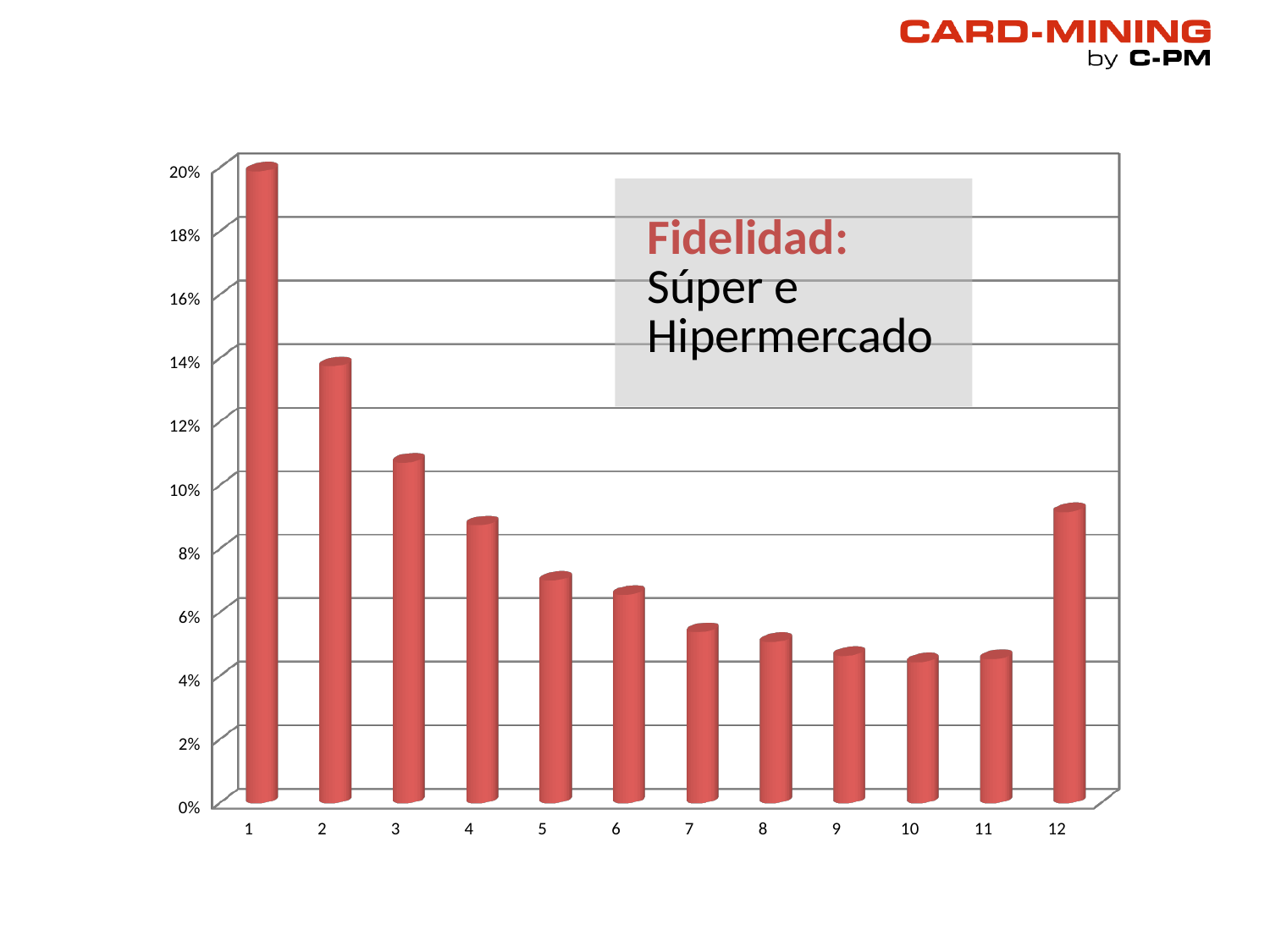
Is the value for category 4 greater or less than 8%? greater What text appears in the box overlaid on the chart? Fidelidad: Súper e Hipermercado Is the value for category 12 greater or less than 10%? less What kind of chart is shown on the slide? bar chart Which is larger, the value for category 2 or category 3? 2 How many categories are plotted along the x axis? 12 Is the value for category 2 greater or less than 12%? greater Do the values rise or fall from category 1 to category 11? fall Which is larger, the value for category 12 or category 4? 12 Which category has the highest value? 1